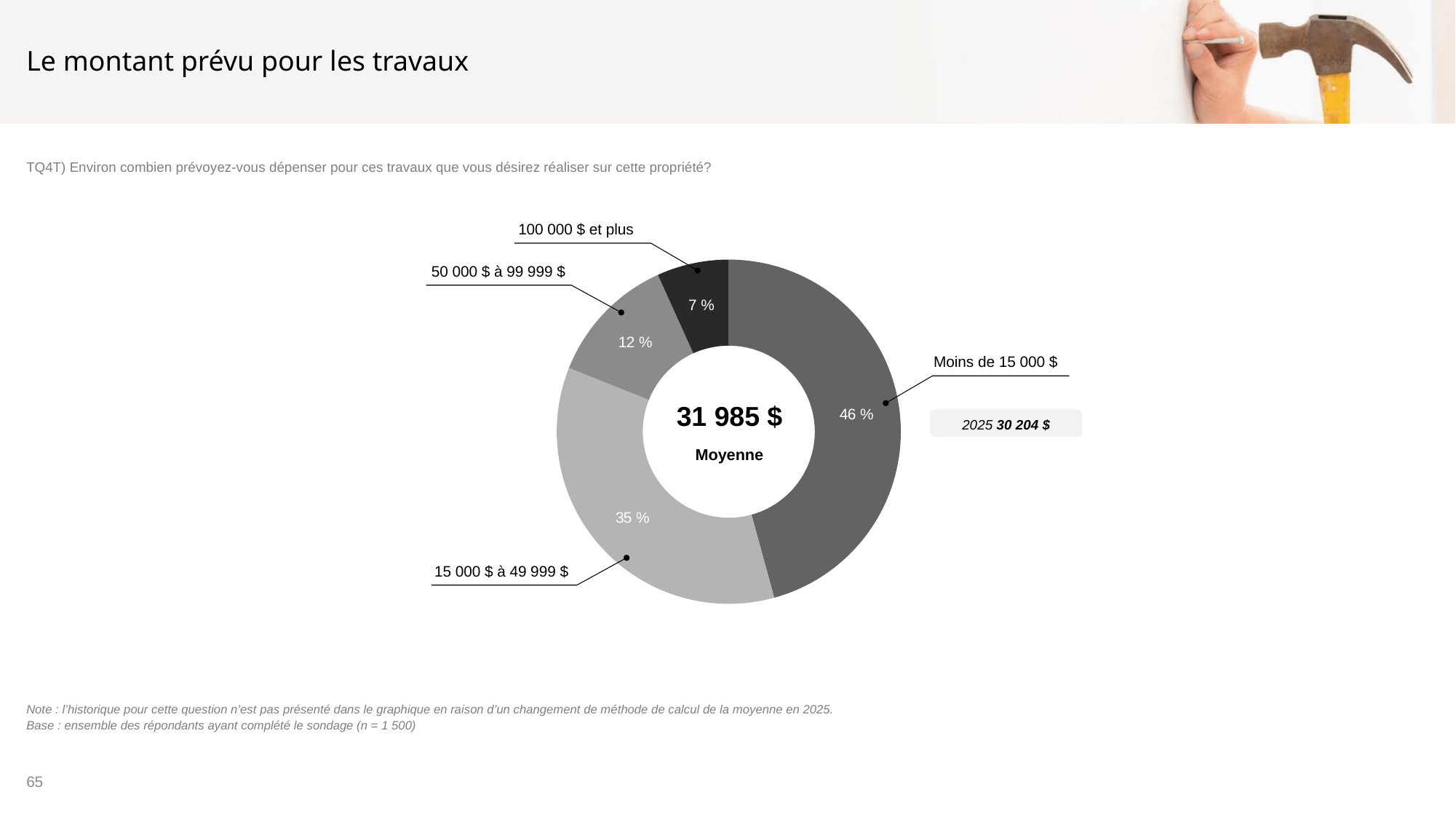
Which spending category has the smallest share? 100 000 $ et plus What share of respondents plan to spend 'Moins de 15 000 $'? 46 % What average amount (Moyenne) is shown in the centre of the chart? 31 985 $ What share of respondents plan to spend '100 000 $ et plus'? 7 % What kind of chart is shown on the slide? Pie chart (donut) What share of respondents plan to spend '50 000 $ à 99 999 $'? 12 % How many spending categories are shown in the chart? 4 What share of respondents plan to spend '15 000 $ à 49 999 $'? 35 % What was the average amount shown for 2025? 30 204 $ What is the difference in percentage points between 'Moins de 15 000 $' and '15 000 $ à 49 999 $'? 11 Which is larger: the share for '50 000 $ à 99 999 $' or for '100 000 $ et plus'? 50 000 $ à 99 999 $ Which spending category has the largest share? Moins de 15 000 $